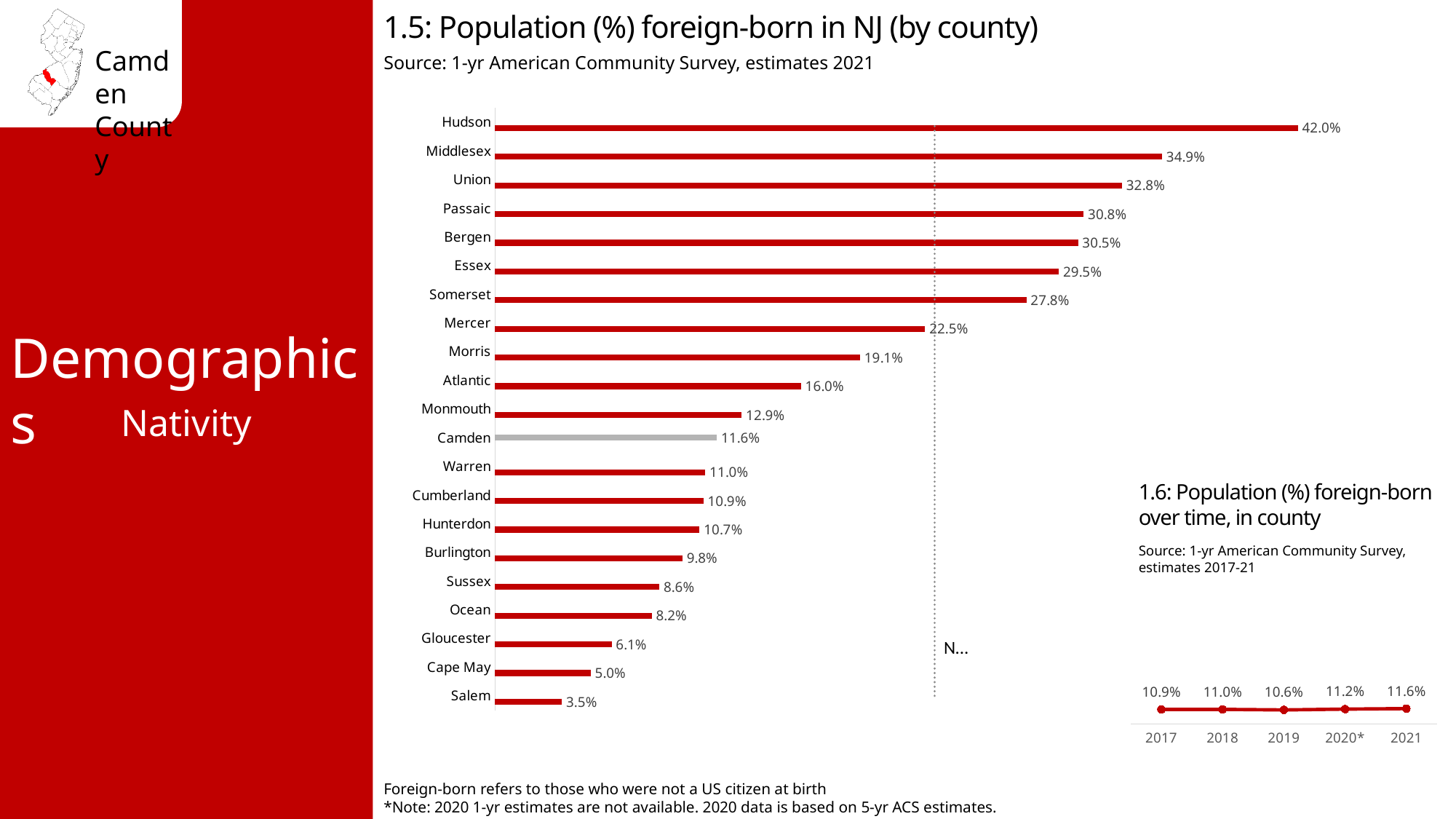
In the chart '1.6: Population (%) foreign-born over time, in county', what is the value for 2019? 10.6% In the chart '1.5: Population (%) foreign-born in NJ (by county)', how many counties are shown? 21 What kind of chart is '1.5: Population (%) foreign-born in NJ (by county)'? Bar chart In the chart '1.5: Population (%) foreign-born in NJ (by county)', which county has the lowest value? Salem In the chart '1.6: Population (%) foreign-born over time, in county', which year has the highest value? 2021 In the chart '1.5: Population (%) foreign-born in NJ (by county)', what is the value for Camden? 11.6% In the chart '1.5: Population (%) foreign-born in NJ (by county)', what is the difference between Hudson and Middlesex? 7.1% In the chart '1.6: Population (%) foreign-born over time, in county', what is the difference between 2021 and 2017? 0.7% In the chart '1.5: Population (%) foreign-born in NJ (by county)', which county has the highest value? Hudson In the chart '1.5: Population (%) foreign-born in NJ (by county)', what is the value for Hudson? 42.0% In the chart '1.5: Population (%) foreign-born in NJ (by county)', which county's bar is coloured grey instead of red? Camden In the chart '1.5: Population (%) foreign-born in NJ (by county)', which is larger, Bergen or Essex? Bergen